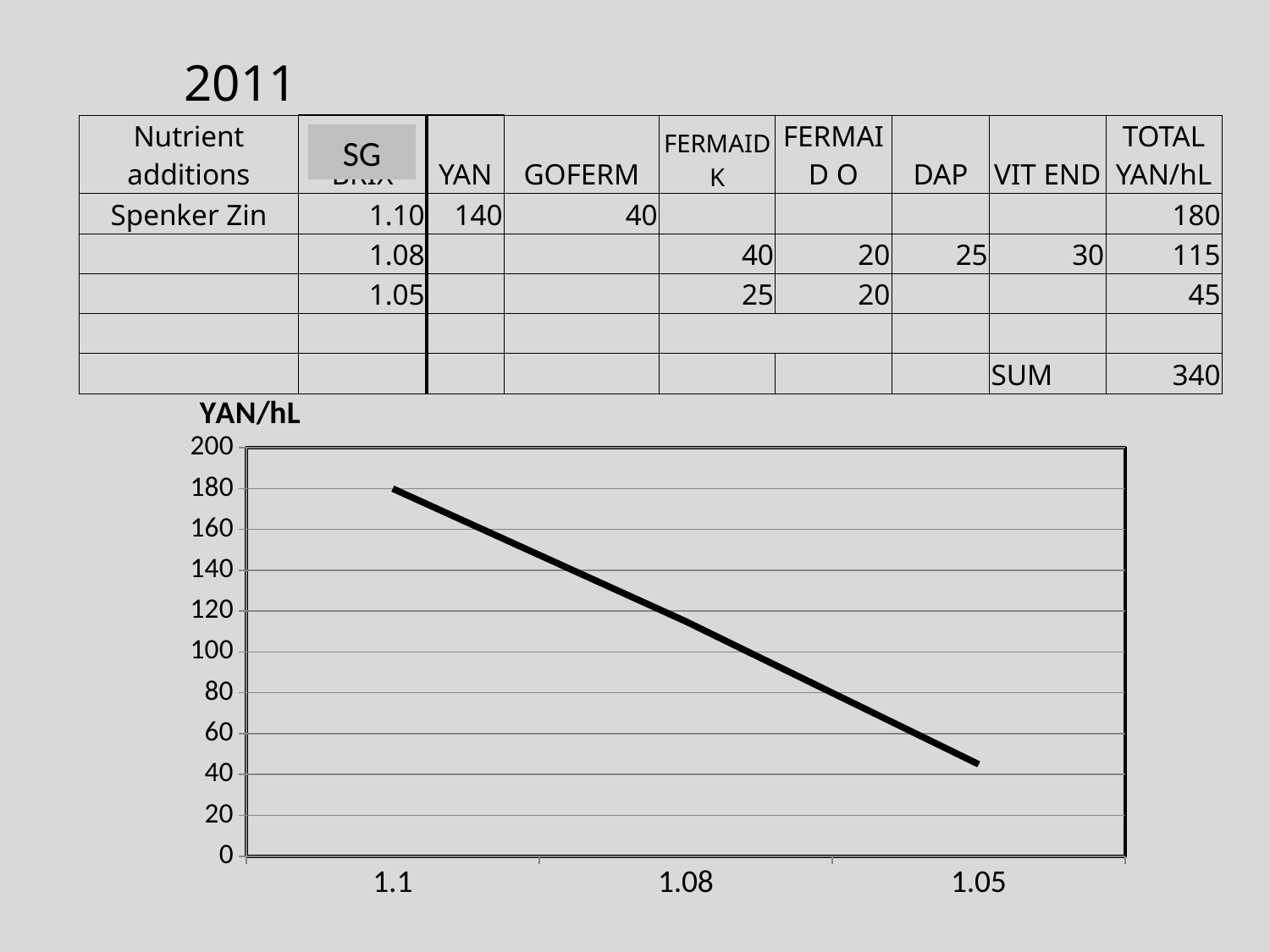
Is the value plotted at 1.05 greater or less than 60? less What are the categories shown on the x axis of the chart, from left to right? 1.1, 1.08, 1.05 Which x-axis category has the lowest YAN/hL value on the chart? 1.05 Which has the larger plotted value, 1.1 or 1.05? 1.1 Is the value plotted at 1.08 greater or less than 140? less Is the value plotted at 1.08 greater or less than 100? greater What kind of chart is shown on the slide? line chart What is the YAN/hL value plotted at 1.1? 180 What is the title of the chart? YAN/hL Which x-axis category has the highest YAN/hL value on the chart? 1.1 How many data points are plotted on the line chart? 3 Do the values rise or fall moving from left to right along the x axis? fall